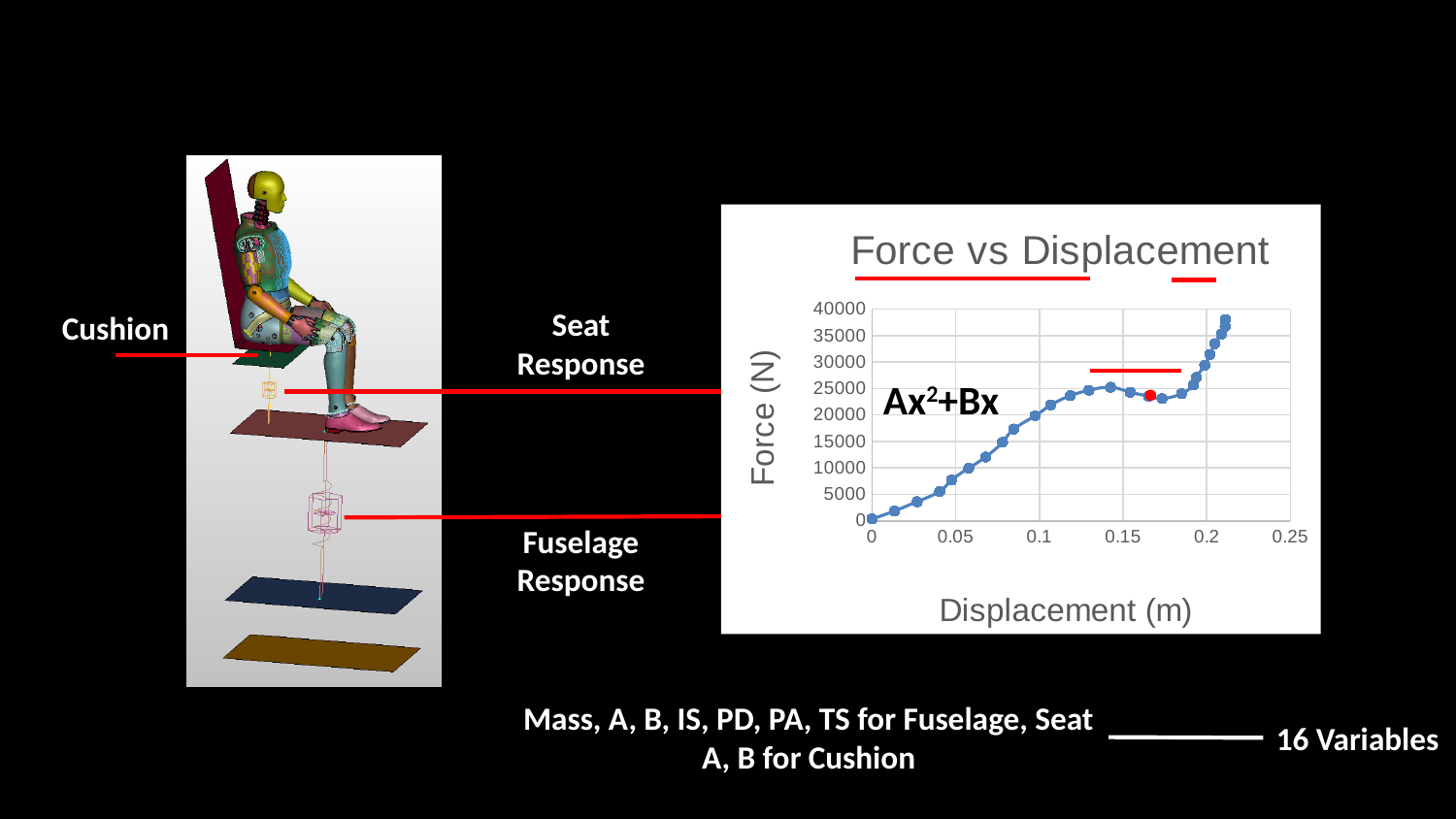
What kind of chart is the Force vs Displacement chart? line chart In the Force vs Displacement chart, does the force generally rise or fall as displacement increases from 0 to 0.1? rise In the Force vs Displacement chart, is the force at a displacement of 0.05 greater or less than 5000? greater What is the largest value shown on the vertical axis of the Force vs Displacement chart? 40000 In the Force vs Displacement chart, is the force at a displacement of 0.1 greater or less than the force at a displacement of 0.05? greater What is the title of the chart on the slide? Force vs Displacement What is the label of the vertical axis of the Force vs Displacement chart? Force (N) In the Force vs Displacement chart, is the highest force value plotted greater or less than 35000? greater What is the largest value shown on the horizontal axis of the Force vs Displacement chart? 0.25 In the Force vs Displacement chart, is the force at a displacement of 0.2 greater or less than 20000? greater